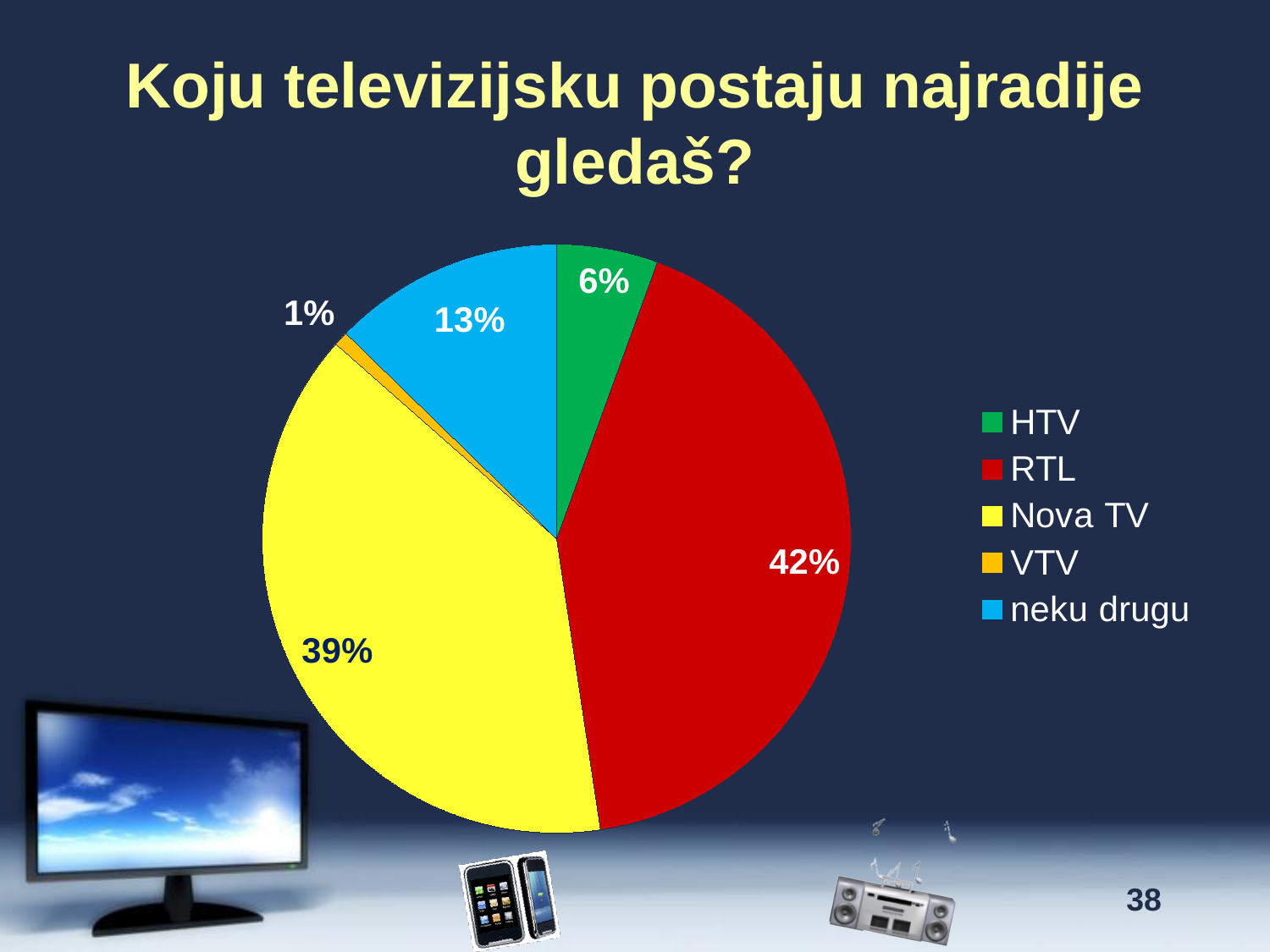
What share of the pie does 'neku drugu' have? 13% Which television station has the largest slice of the pie? RTL What colour is the slice for Nova TV? yellow What kind of chart is shown on the slide? pie chart Which television station has the smallest slice of the pie? VTV What share of the pie does Nova TV have? 39% What share of the pie does VTV have? 1% How many categories does the legend list? 5 Which is larger, the share for HTV or the share for 'neku drugu'? neku drugu What is the difference in percentage points between RTL and Nova TV? 3%